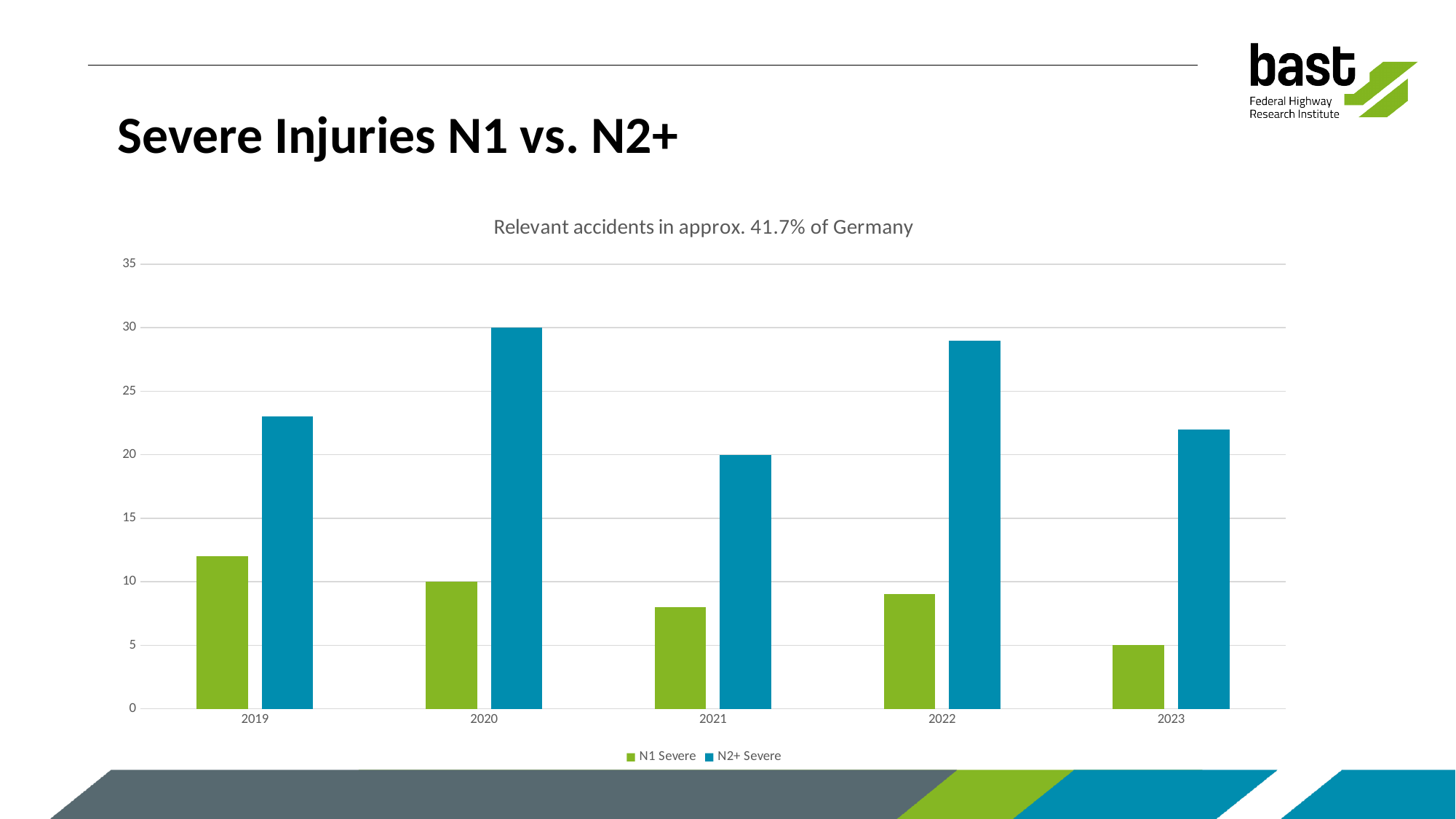
What is the difference between N2+ Severe in 2020 and N2+ Severe in 2021? 10 Which year has the lowest value for N1 Severe? 2023 What is the value for N2+ Severe in 2020? 30 How many years are shown on the x axis? 5 What is the value for N1 Severe in 2023? 5 Which year has the highest value for N1 Severe? 2019 How many series does the legend list? 2 What is the value for N2+ Severe in 2021? 20 What kind of chart is shown on the slide? Bar chart Is the value for N2+ Severe in 2019 greater or less than 20? greater What is the subtitle shown above the chart? Relevant accidents in approx. 41.7% of Germany What is the value for N1 Severe in 2020? 10